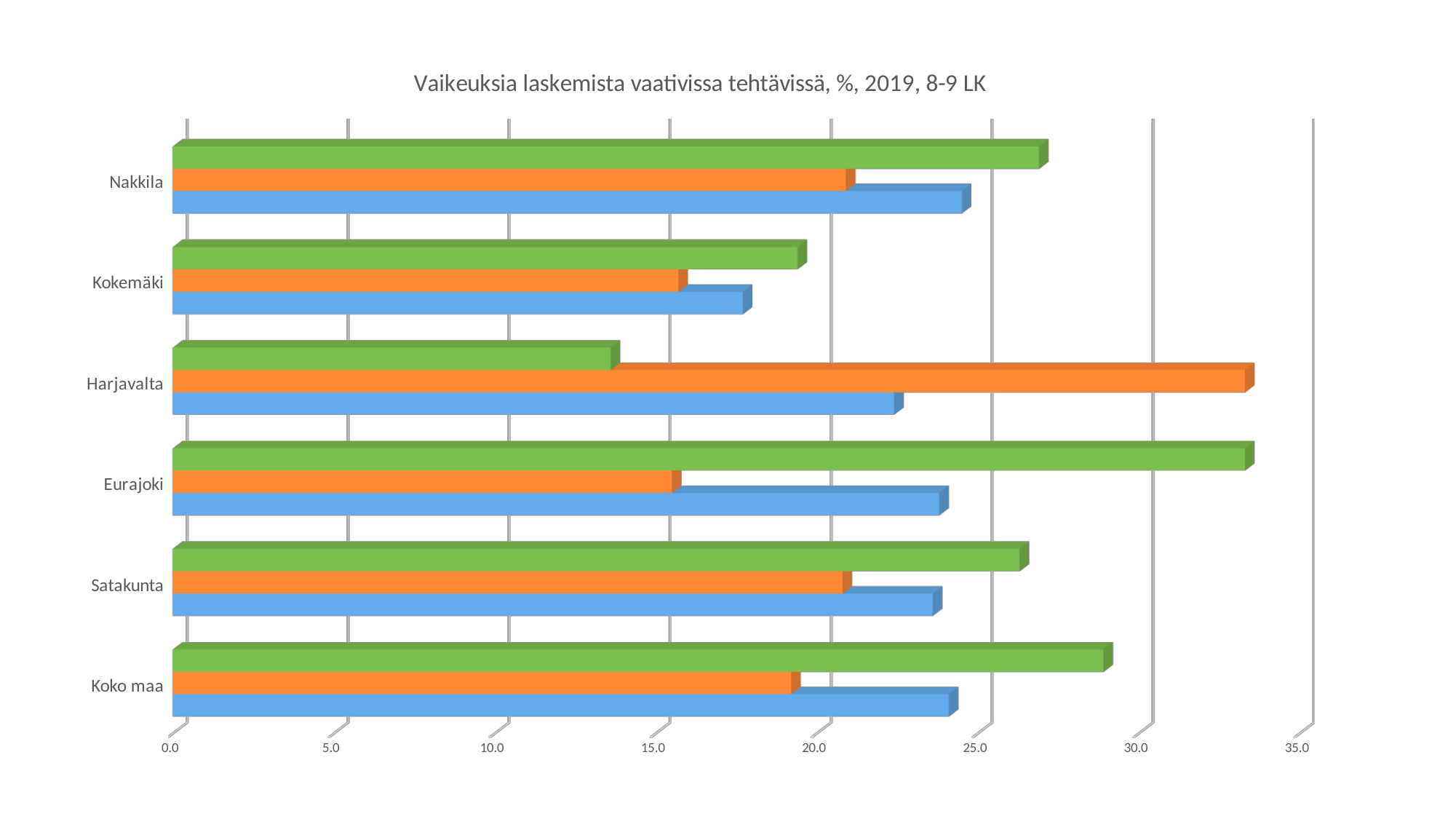
For Nakkila, which is larger: the blue bar or the orange bar? the blue bar What kind of chart is shown on the slide? bar chart Is the value of the green bar for Eurajoki greater or less than 30.0? greater Which category has the shortest blue bar? Kokemäki How many categories are shown on the vertical axis of the chart? 6 What is the title of the chart? Vaikeuksia laskemista vaativissa tehtävissä, %, 2019, 8-9 LK Which category has the longest green bar? Eurajoki Is the value of the orange bar for Harjavalta greater or less than 30.0? greater How many bars are plotted for each category in the chart? 3 Is the value of the green bar for Harjavalta greater or less than 15.0? less Which category has the longest orange bar? Harjavalta